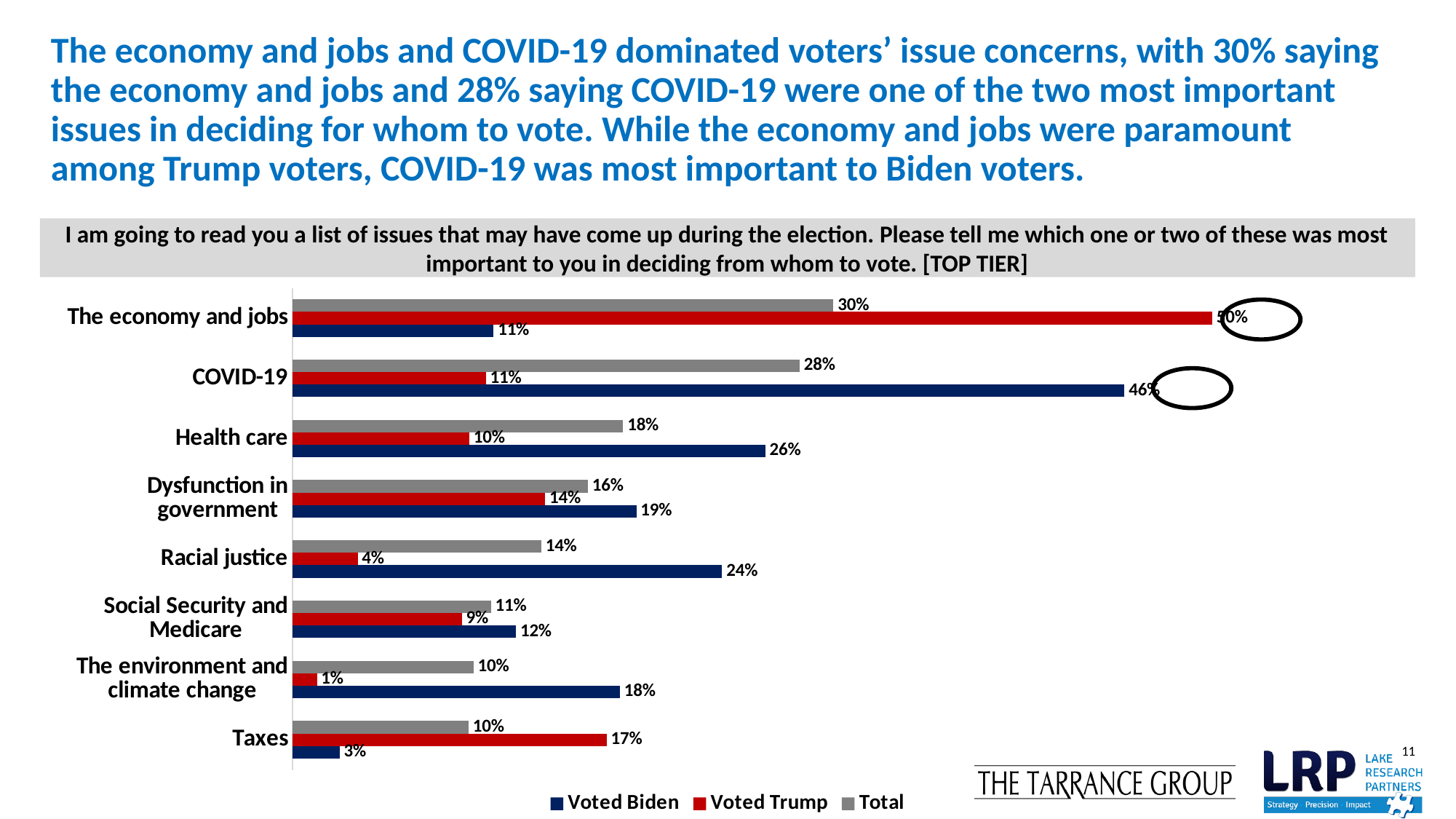
Which colour represents the Voted Trump series? Red What percentage of Biden voters named COVID-19 as a most important issue? 46% What is the Total value for Health care? 18% Which issue has the highest Total value? The economy and jobs What is the Voted Trump value for The environment and climate change? 1% What percentage of Trump voters named the economy and jobs as a most important issue? 50% What is the difference between the Voted Biden and Voted Trump values for Racial justice? 20% Which issue has the lowest Voted Biden value? Taxes How many issues are listed on the chart? 8 How many series does the legend list? 3 What type of chart is shown on the slide? Bar chart For Taxes, which is larger: the Voted Trump value or the Voted Biden value? Voted Trump